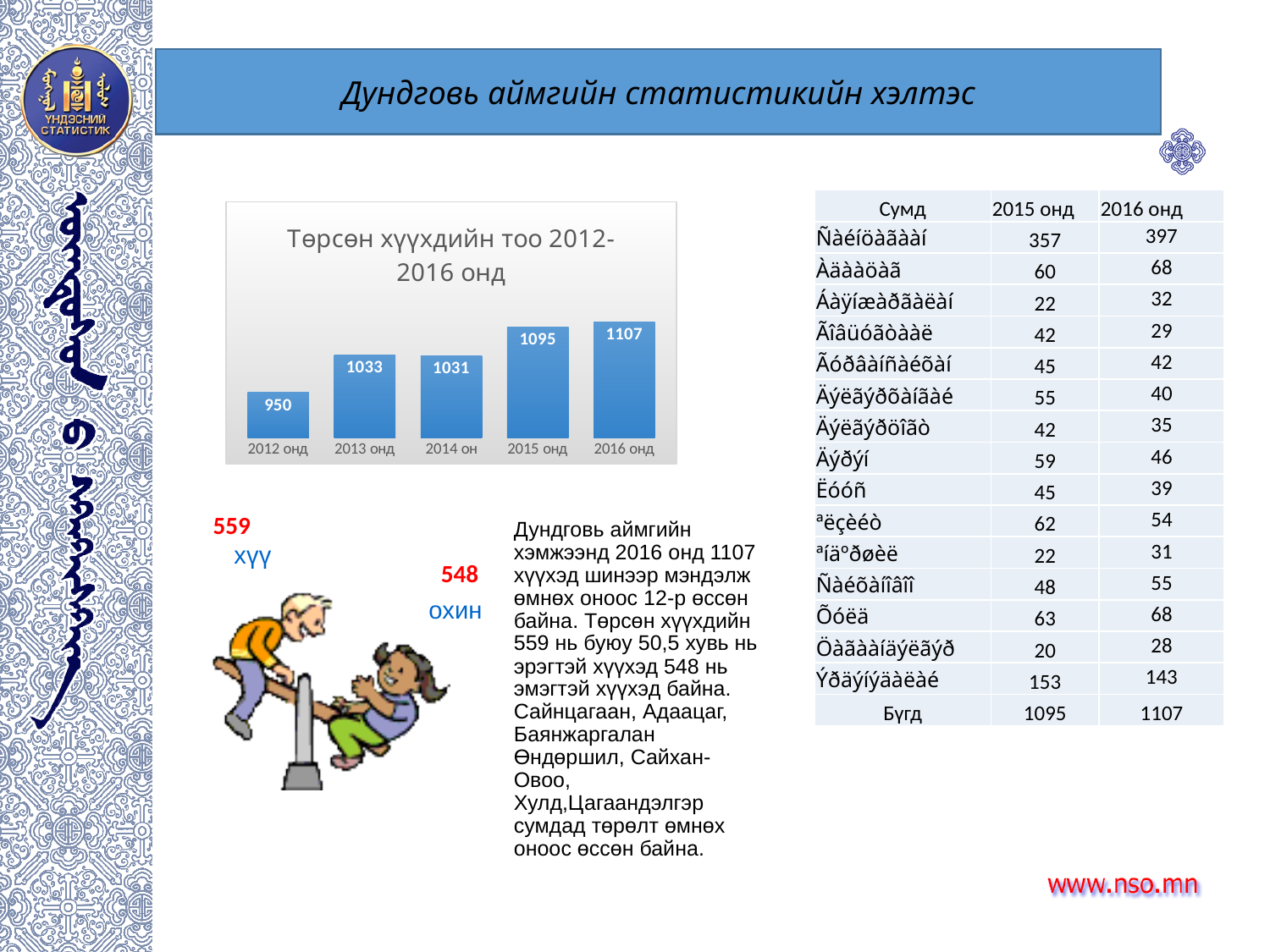
Do the values in the chart generally rise or fall from 2012 to 2016? rise What is the difference between the values for 2016 онд and 2015 онд? 12 What kind of chart is shown on the slide? bar chart What is the value for 2012 онд in the chart? 950 Which year has the lowest value in the chart? 2012 онд What is the difference between the values for 2013 онд and 2012 онд? 83 What is the title of the chart? Төрсөн хүүхдийн тоо 2012-2016 онд How many years are shown in the chart? 5 What is the value for 2016 онд in the chart? 1107 What is the value for 2014 он in the chart? 1031 Which year has the highest value in the chart? 2016 онд Which is larger, the value for 2013 онд or the value for 2012 онд? 2013 онд